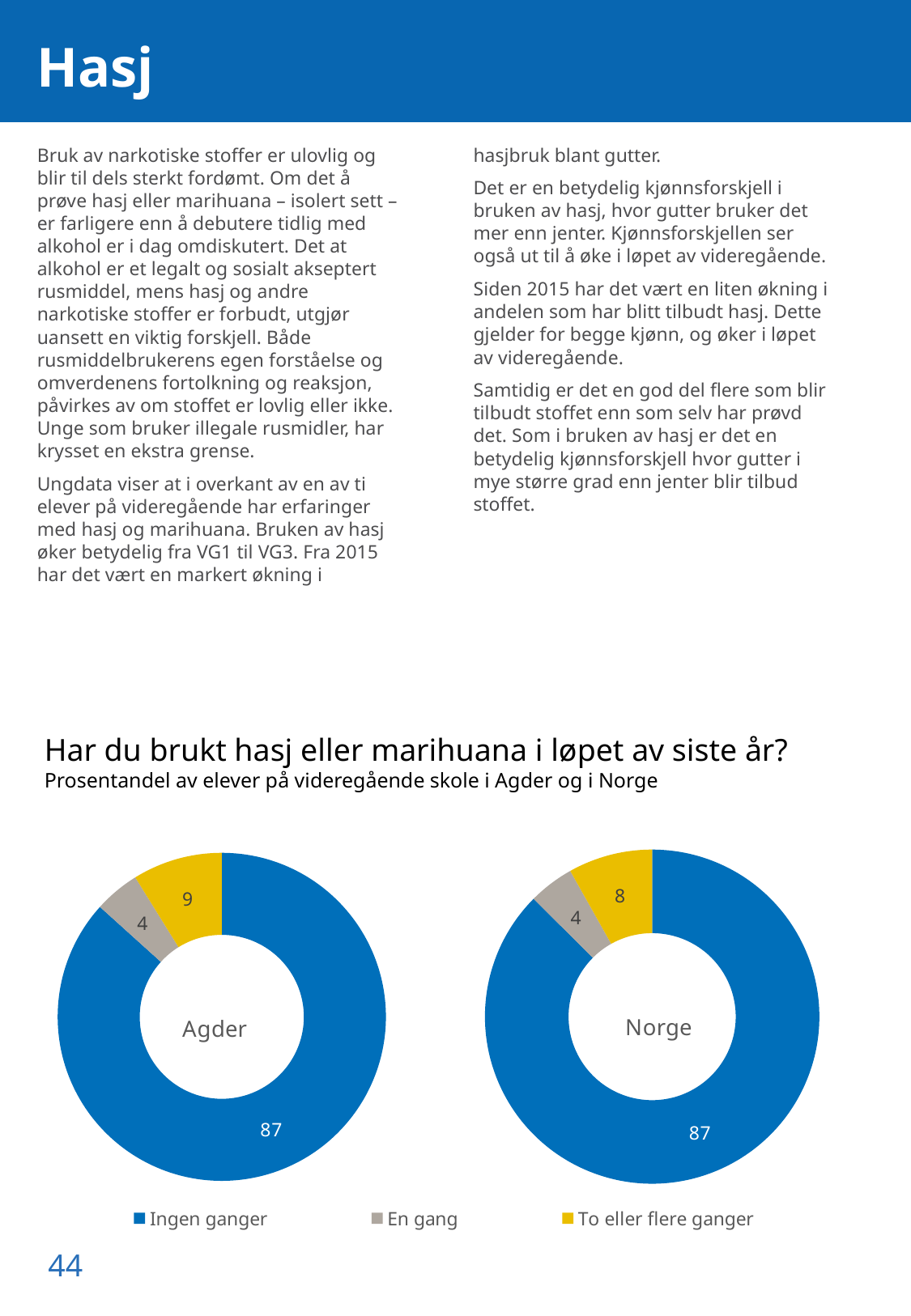
How many categories does each donut chart show? 3 In the Agder chart, what is the value for "To eller flere ganger"? 9 What is the difference between the "To eller flere ganger" value in the Agder chart and in the Norge chart? 1 What colour represents "Ingen ganger" in the charts? Blue In the Norge chart, what is the value for "To eller flere ganger"? 8 Which is larger in the Agder chart: the value for "En gang" or the value for "To eller flere ganger"? To eller flere ganger In the Agder chart, what is the value for "Ingen ganger"? 87 How many entries does the legend list? 3 In the Agder chart, which category has the smallest share? En gang What kind of chart is used to show the Agder and Norge data? Donut (pie) chart In the Norge chart, which category has the largest share? Ingen ganger In the Agder chart, what is the value for "En gang"? 4